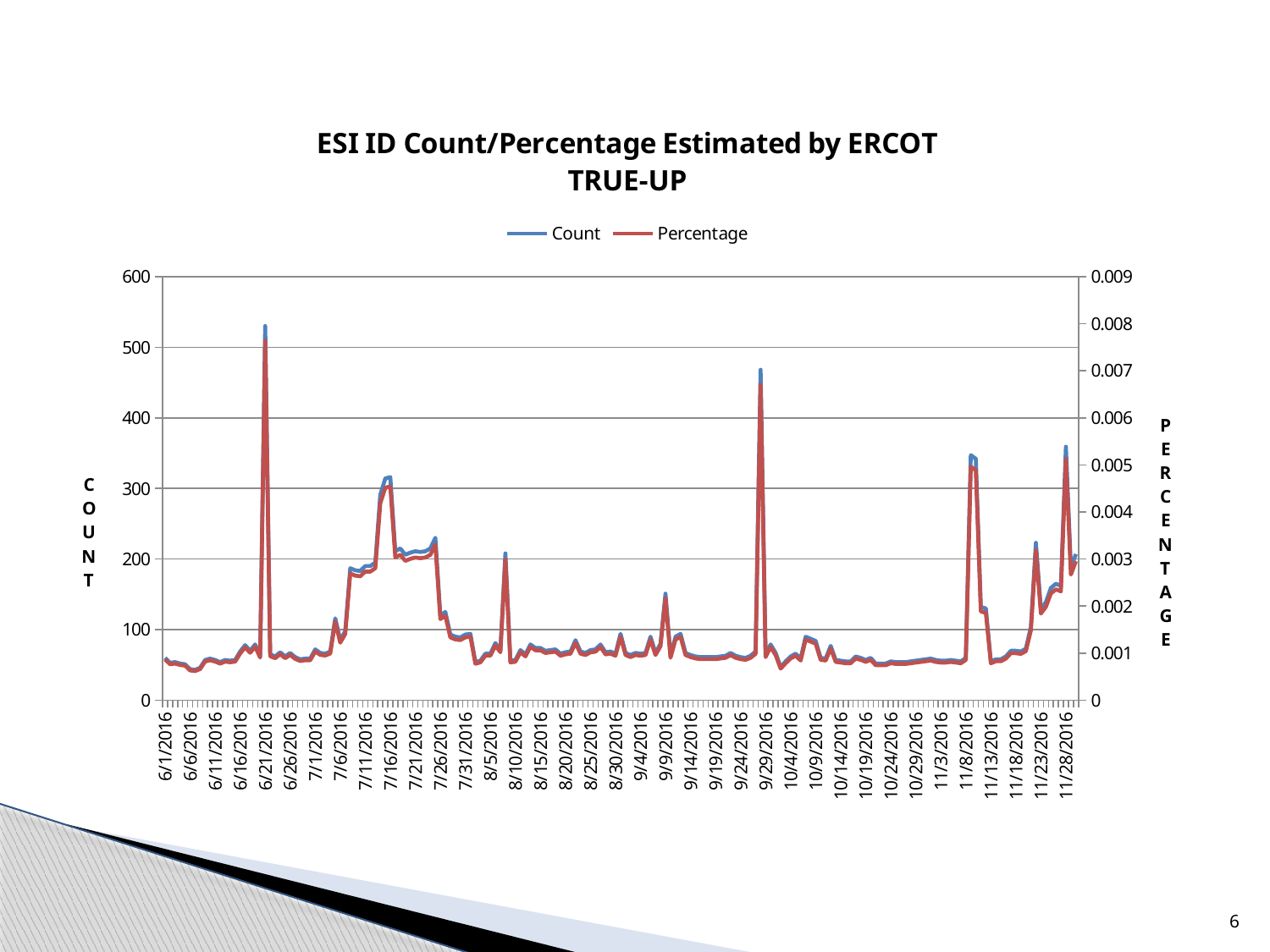
What kind of chart is shown on the slide? line chart Is the Count value on 6/1/2016 greater or less than 100? less What is the title of the chart? ESI ID Count/Percentage Estimated by ERCOT TRUE-UP Is the Count value around 7/16/2016 greater or less than 200? greater Is the Count value at its highest peak near 6/21/2016 greater or less than 500? greater What is the maximum value shown on the right-hand Percentage axis? 0.009 Around which date does the Count series reach its highest peak? 6/21/2016 How many series does the legend list? 2 Which series is drawn in red? Percentage